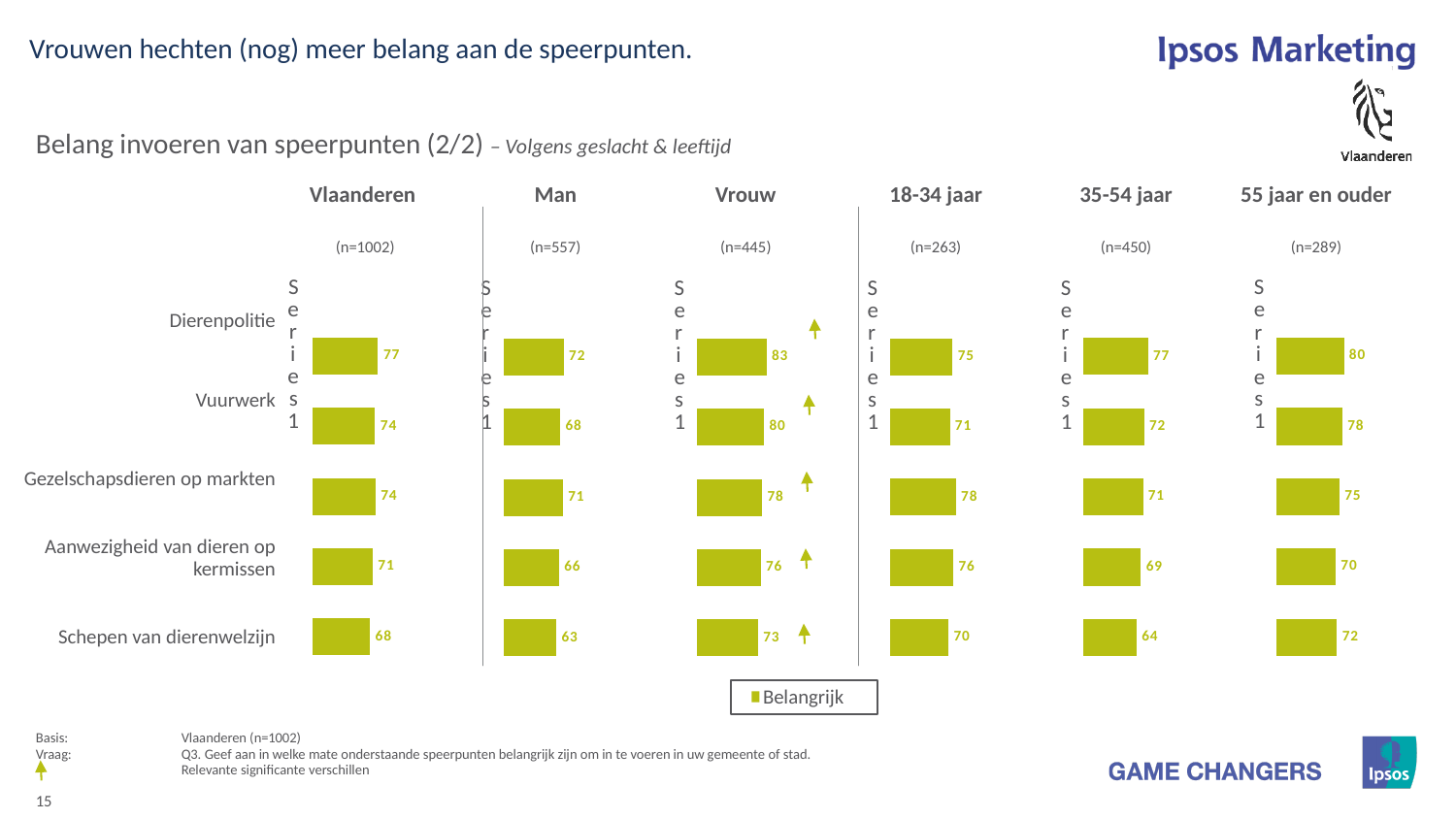
How many categories are shown in the Vlaanderen chart? 5 In the 18-34 jaar chart, which category has the highest value? Gezelschapsdieren op markten What is the legend entry shown below the charts? Belangrijk What kind of chart is used for the Man chart? Bar chart In the Vlaanderen chart, which category has the highest value? Dierenpolitie In the 55 jaar en ouder chart, what is the value for Vuurwerk? 78 In the Man chart, what is the value for Schepen van dierenwelzijn? 63 In the Vrouw chart, what is the value for Dierenpolitie? 83 For Aanwezigheid van dieren op kermissen, which is larger: the value in the Vrouw chart or the value in the 35-54 jaar chart? Vrouw In the 18-34 jaar chart, what is the value for Gezelschapsdieren op markten? 78 In the 35-54 jaar chart, which category has the lowest value? Schepen van dierenwelzijn What is the difference between the Vrouw and Man values for Dierenpolitie? 11